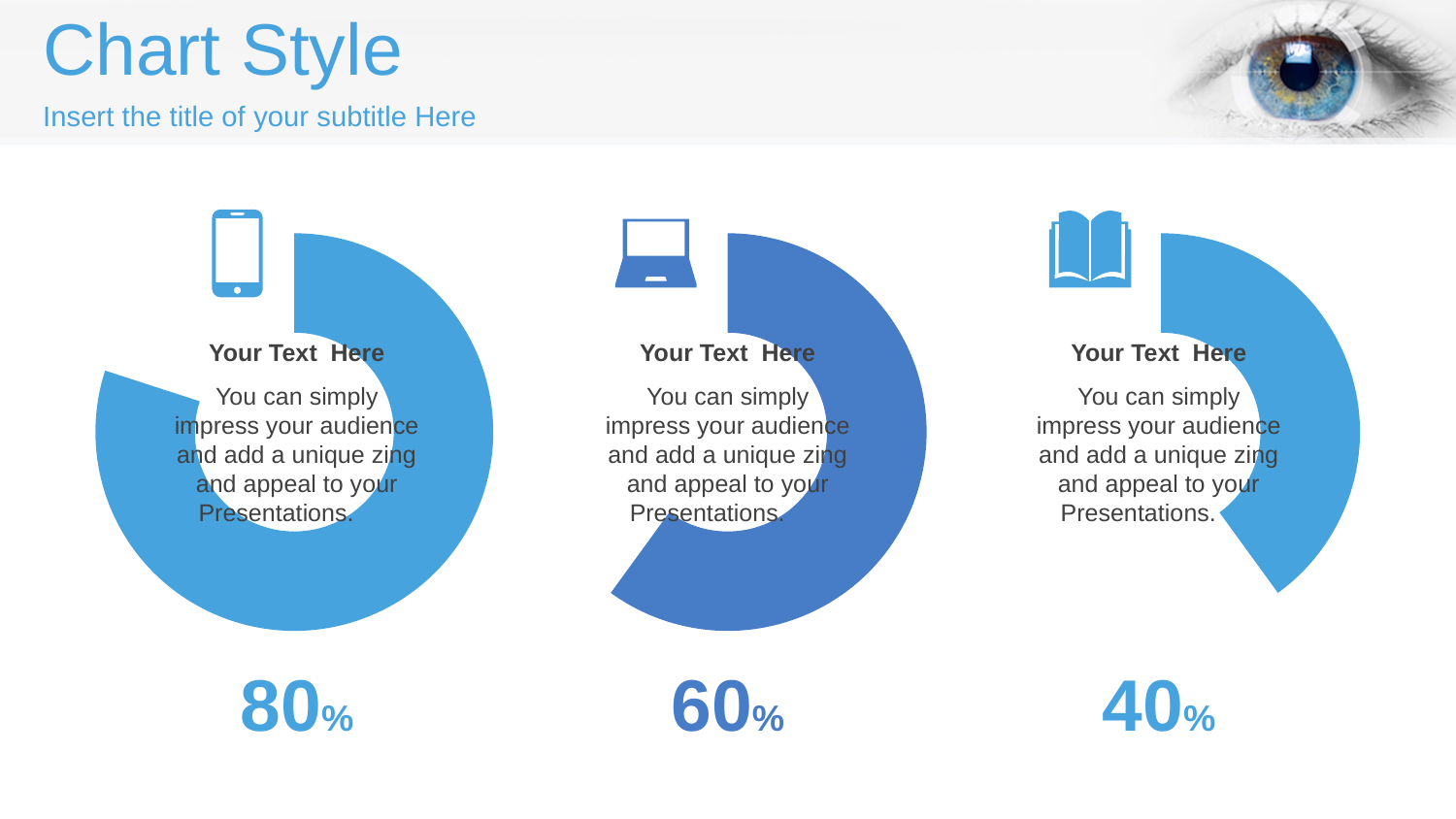
What is the difference between the percentage of the left chart and the percentage of the middle chart? 20% Which is larger, the percentage of the middle chart or the percentage of the right chart? The middle chart (60%) What percentage is shown below the right doughnut chart (with the book icon)? 40% What percentage is shown below the middle doughnut chart (with the laptop icon)? 60% What is the difference between the percentage of the left chart and the percentage of the right chart? 40% Which of the three doughnut charts shows the highest percentage? The left chart (80%) How many doughnut charts are shown on the slide? 3 Do the percentages rise or fall from the left chart to the right chart? Fall What is the title of the slide? Chart Style What kind of chart is used on this slide? Doughnut chart What percentage is shown below the left doughnut chart (with the phone icon)? 80% Which of the three doughnut charts shows the lowest percentage? The right chart (40%)